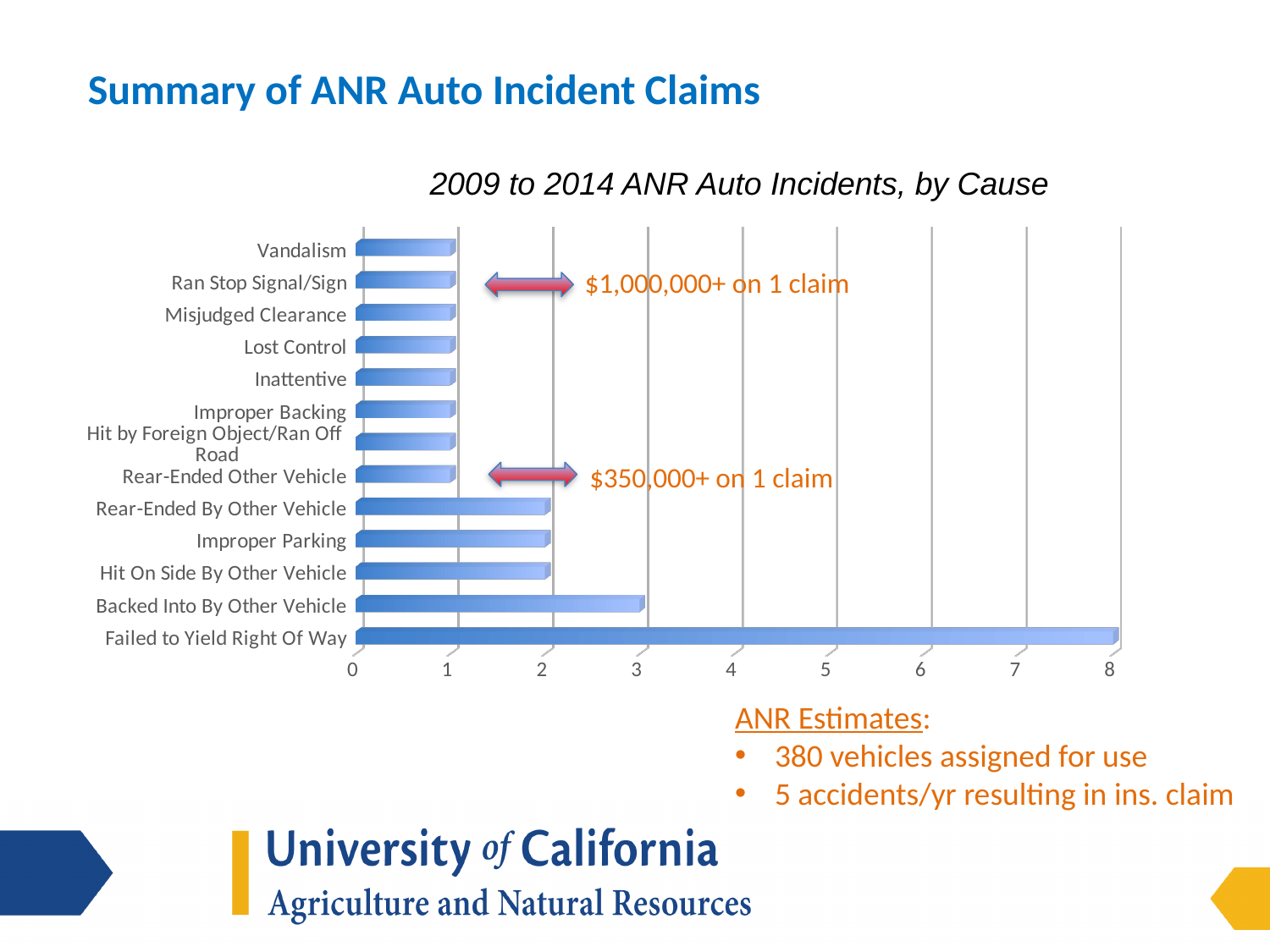
How many causes (categories) are listed in the chart? 13 How many incidents are shown for Backed Into By Other Vehicle? 3 What is the difference in incidents between Failed to Yield Right Of Way and Backed Into By Other Vehicle? 5 How many incidents are shown for Improper Parking? 2 How many incidents are shown for Failed to Yield Right Of Way? 8 Which has more incidents, Rear-Ended By Other Vehicle or Rear-Ended Other Vehicle? Rear-Ended By Other Vehicle How many incidents are shown for Vandalism? 1 What is the title of the chart? 2009 to 2014 ANR Auto Incidents, by Cause Is the value for Failed to Yield Right Of Way greater or less than 5? greater What type of chart is shown on the slide? bar chart Which cause has the highest number of incidents? Failed to Yield Right Of Way Which cause is annotated with "$1,000,000+ on 1 claim"? Ran Stop Signal/Sign